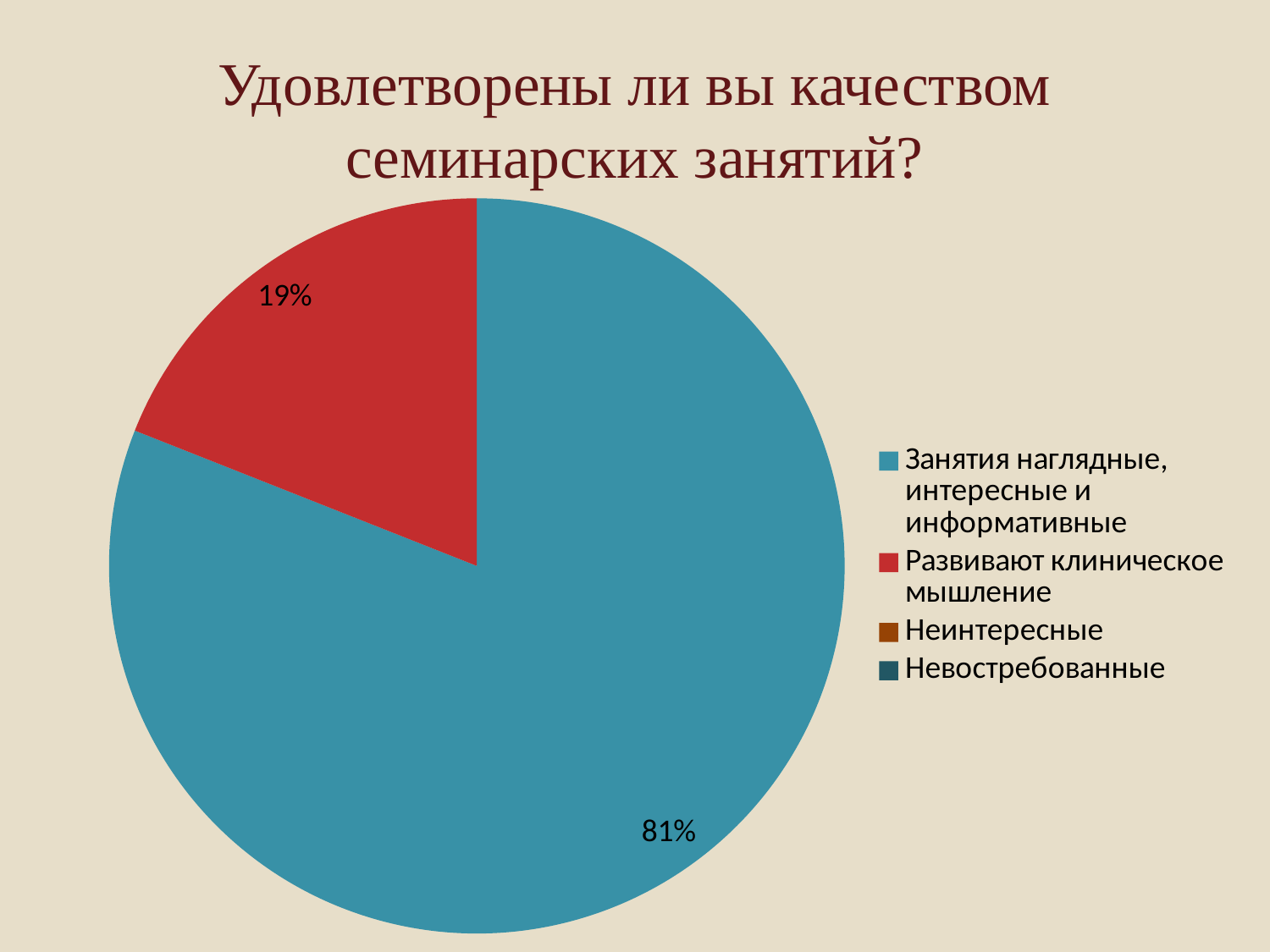
How many entries does the legend list? 4 What colour is the slice for "Развивают клиническое мышление"? red By how many percentage points does the "Занятия наглядные, интересные и информативные" slice exceed the "Развивают клиническое мышление" slice? 62 percentage points What is the title of the chart? Удовлетворены ли вы качеством семинарских занятий? Which is larger: the slice for "Развивают клиническое мышление" or the slice for "Занятия наглядные, интересные и информативные"? Занятия наглядные, интересные и информативные How many slices with data labels are visible in the pie? 2 What percentage is shown for "Развивают клиническое мышление"? 19% Which category has the largest slice of the pie? Занятия наглядные, интересные и информативные What kind of chart is shown on the slide? pie chart What percentage is shown for "Занятия наглядные, интересные и информативные"? 81% What share of the pie does the blue slice represent? 81%